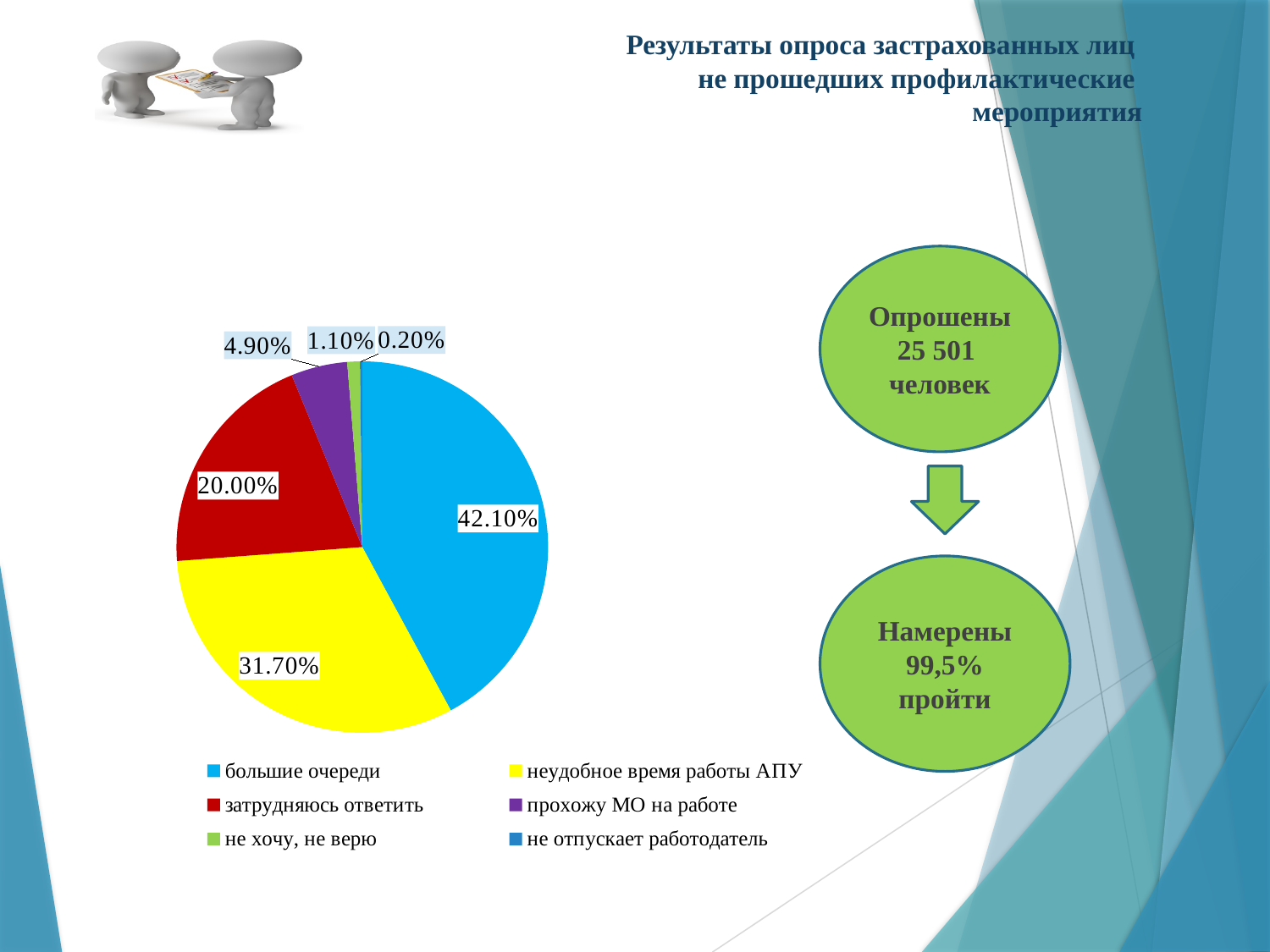
Which category has the largest share of the pie? большие очереди What percentage of respondents chose "прохожу МО на работе"? 4.90% What percentage of respondents chose "не отпускает работодатель"? 0.20% What percentage of respondents chose "неудобное время работы АПУ"? 31.70% Which colour represents "не хочу, не верю" in the legend? green What percentage of respondents chose "затрудняюсь ответить"? 20.00% How many categories does the pie chart have? 6 What is the difference between the shares for "большие очереди" and "неудобное время работы АПУ"? 10.40% What percentage of respondents chose "большие очереди"? 42.10% Which category has the smallest share of the pie? не отпускает работодатель What type of chart is shown on the slide? pie chart Which is larger: the share for "затрудняюсь ответить" or the share for "прохожу МО на работе"? затрудняюсь ответить